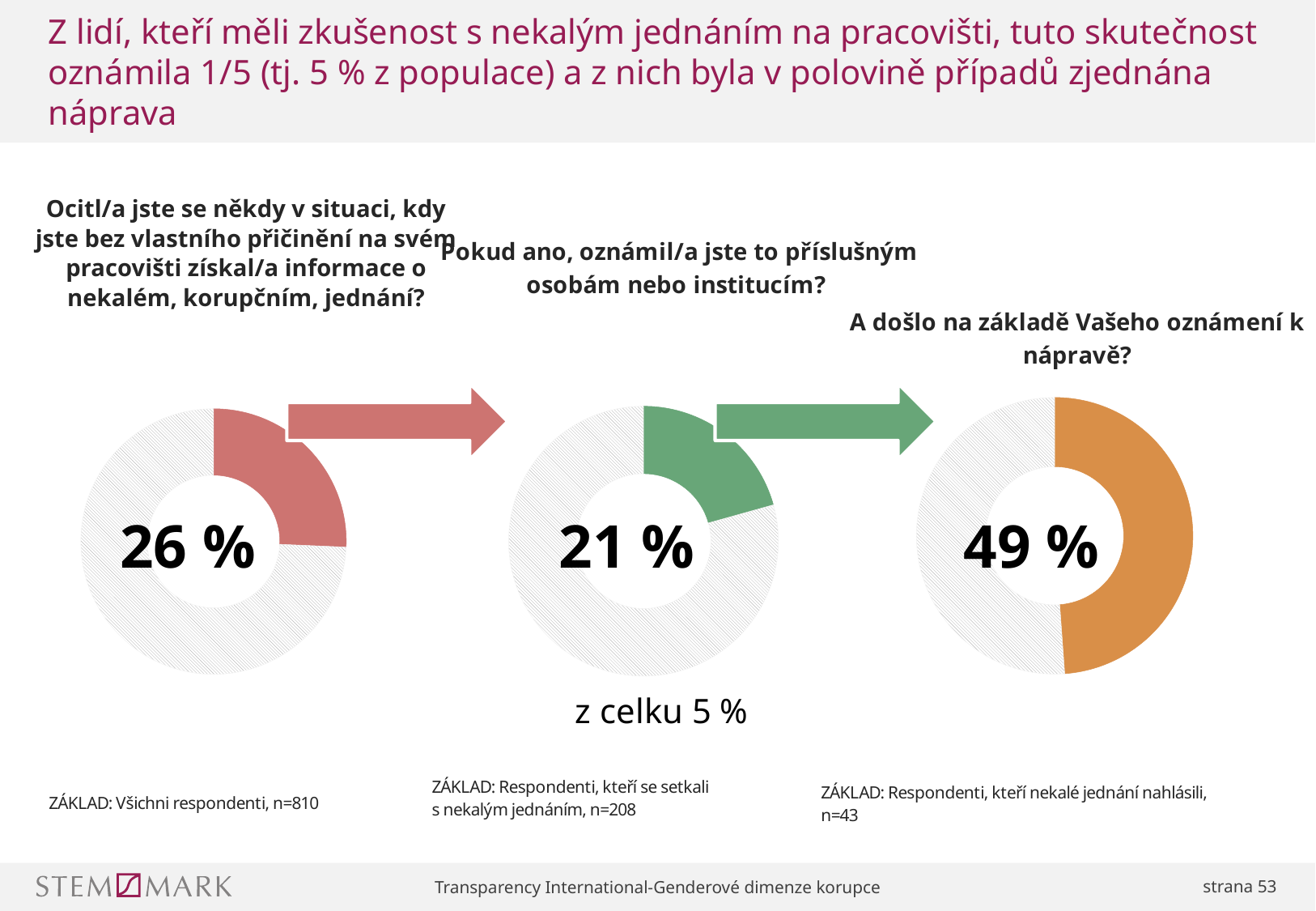
What share of the total population does the text under the middle donut chart state? 5 % What is the difference in percentage points between the right donut chart (49 %) and the left donut chart (26 %)? 23 percentage points What colour is the highlighted slice in the right donut chart? Orange What is the base (n) stated for the left donut chart? n=810 In the right donut chart ("A došlo na základě Vašeho oznámení k nápravě?"), what percentage is shown? 49 % What kind of charts are shown on the slide? Donut (pie) charts How many donut charts are on the slide? 3 Which of the three donut charts shows the highest percentage? The right chart (A došlo na základě Vašeho oznámení k nápravě?), 49 % Which of the three donut charts shows the lowest percentage? The middle chart (Pokud ano, oznámil/a jste to příslušným osobám nebo institucím?), 21 % In the left donut chart ("Ocitl/a jste se někdy v situaci..."), what percentage is shown? 26 % Which is larger: the value in the left donut chart or the value in the middle donut chart? The left donut chart (26 %) In the middle donut chart ("Pokud ano, oznámil/a jste to příslušným osobám nebo institucím?"), what percentage is shown? 21 %